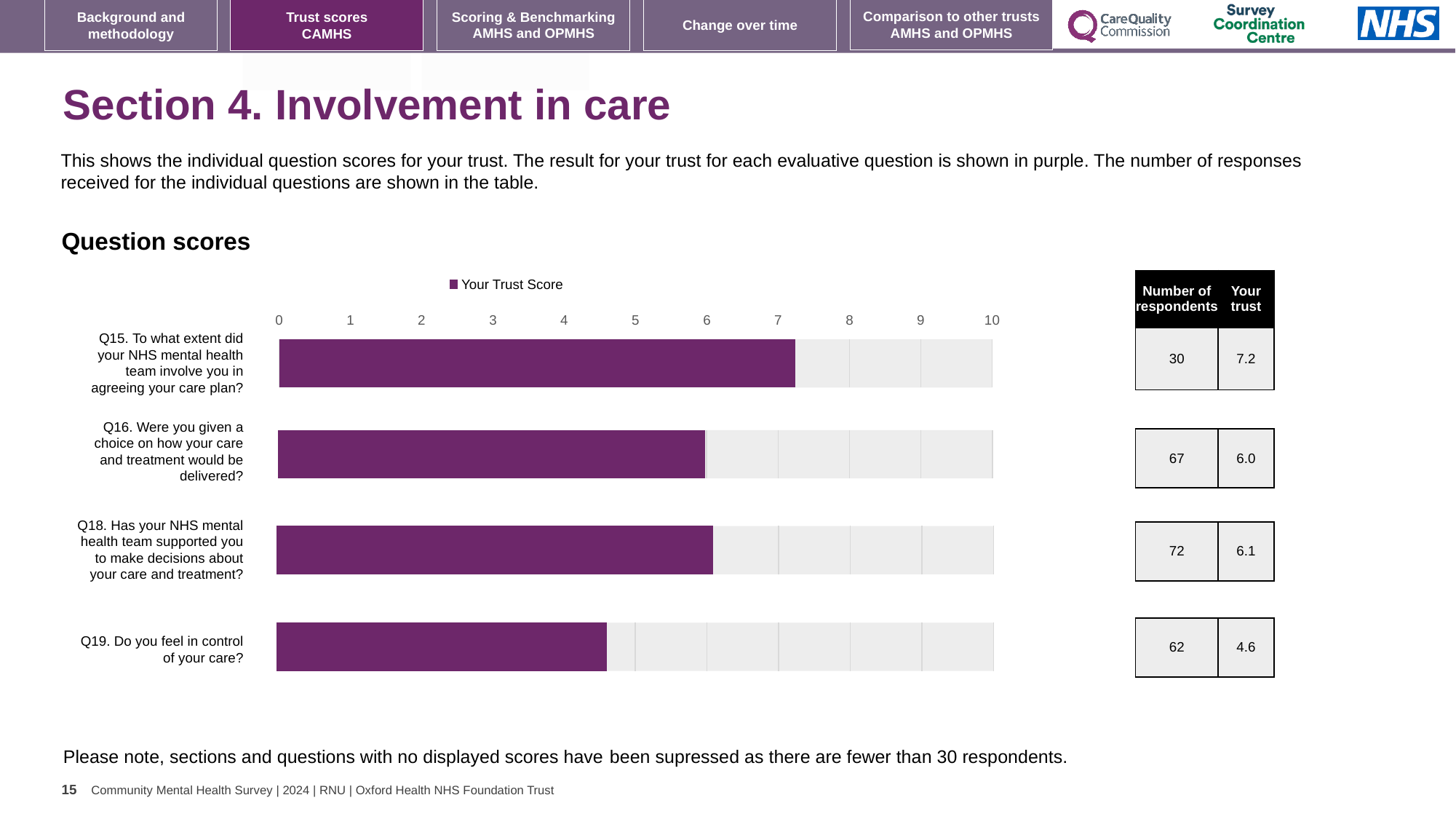
What is the difference between the Your Trust Score for Q15 and for Q19? 2.6 What kind of chart is used to show the question scores? Bar chart Which has a higher Your Trust Score, Q15 or Q18? Q15 Which question has the lowest Your Trust Score? Q19 How many series does the legend of the Question scores chart list? 1 How many questions are plotted in the Question scores chart? 4 Is the Your Trust Score for Q19 greater or less than 5? less What is the Your Trust Score for Q19 (Do you feel in control of your care?)? 4.6 What is the Your Trust Score for Q16 (Were you given a choice on how your care and treatment would be delivered?)? 6.0 Which question has the highest Your Trust Score? Q15 What is the Your Trust Score for Q15 (To what extent did your NHS mental health team involve you in agreeing your care plan?)? 7.2 What is the maximum value shown on the chart's axis? 10